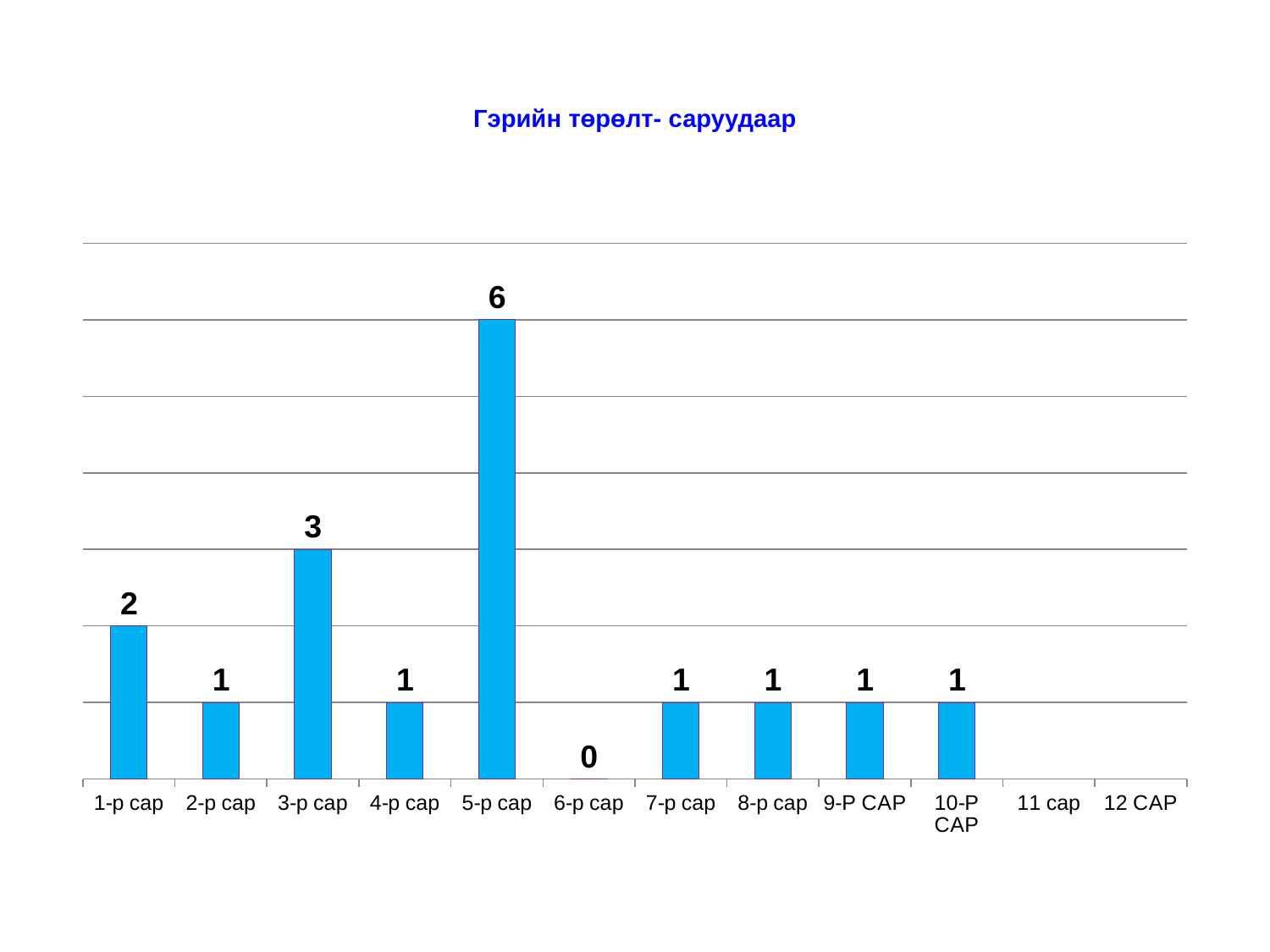
What is the total of the values for 7-р сар, 8-р сар, 9-Р САР and 10-Р САР? 4 What is the value for 1-р сар? 2 What is the difference between the values for 5-р сар and 3-р сар? 3 How many categories are shown on the x axis? 12 What is the value for 6-р сар? 0 Which month has the highest value? 5-р сар What is the title of the chart? Гэрийн төрөлт- саруудаар Which is larger, the value for 1-р сар or the value for 2-р сар? 1-р сар Which month has the lowest labelled value? 6-р сар What kind of chart is this? bar chart What is the value for 3-р сар? 3 What is the value for 5-р сар? 6